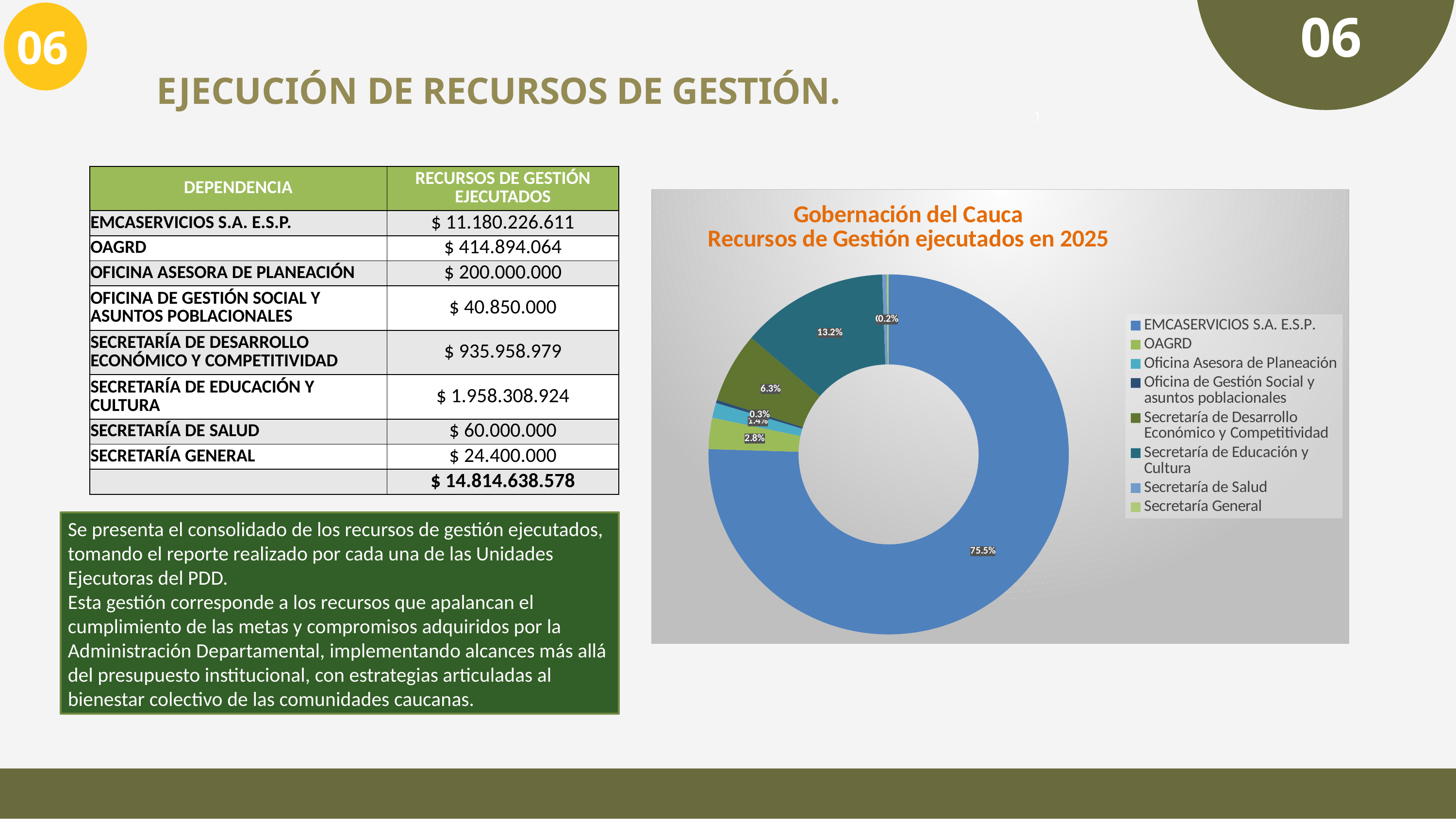
What colour is the slice for EMCASERVICIOS S.A. E.S.P. in the chart? Blue What share of the chart does Secretaría de Desarrollo Económico y Competitividad represent? 6.3% How many entries does the chart legend list? 8 What share of the chart does Oficina Asesora de Planeación represent? 1.4% Which dependency has the largest share of the chart? EMCASERVICIOS S.A. E.S.P. What share of the chart does Secretaría de Educación y Cultura represent? 13.2% Which has a larger share of the chart, Secretaría de Educación y Cultura or Secretaría de Desarrollo Económico y Competitividad? Secretaría de Educación y Cultura What is the difference in percentage points between the EMCASERVICIOS S.A. E.S.P. share and the Secretaría de Educación y Cultura share? 62.3 percentage points What is the title of the chart? Gobernación del Cauca Recursos de Gestión ejecutados en 2025 What kind of chart is shown on the slide? Doughnut (pie) chart